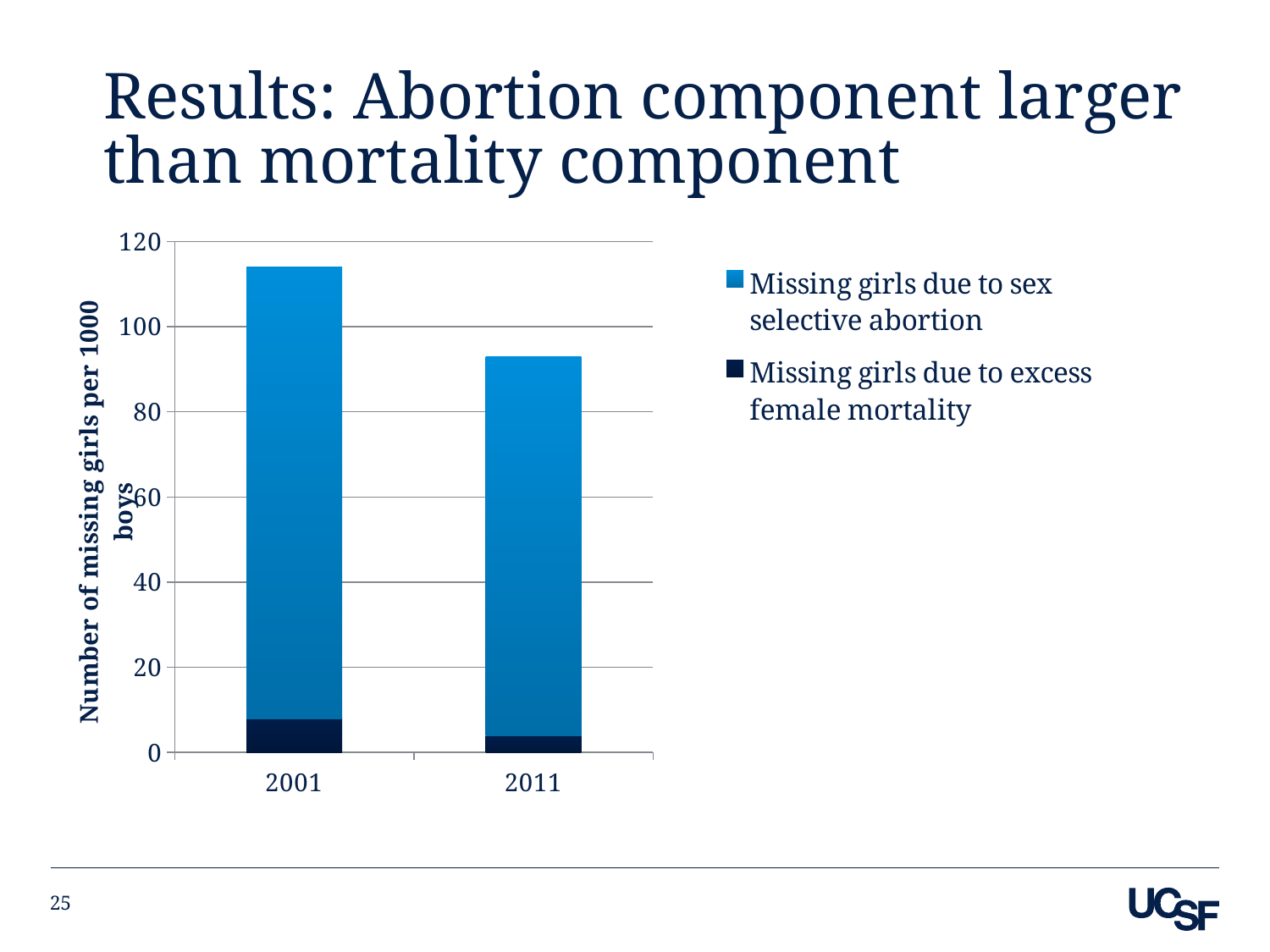
Is the total value for 2011 greater or less than 80? greater Which series is shown in dark navy at the bottom of each bar? Missing girls due to excess female mortality Does the total number of missing girls per 1000 boys rise or fall from 2001 to 2011? fall Which year has the lowest total number of missing girls per 1000 boys? 2011 What kind of chart is shown on the slide? stacked bar chart Is the total value for 2011 greater or less than 100? less Which year has the taller stacked bar, 2001 or 2011? 2001 How many series does the chart's legend list? 2 Is the total value for 2001 greater or less than 100? greater What is the title of the chart's y axis? Number of missing girls per 1000 boys How many years (categories) are shown on the x axis of the chart? 2